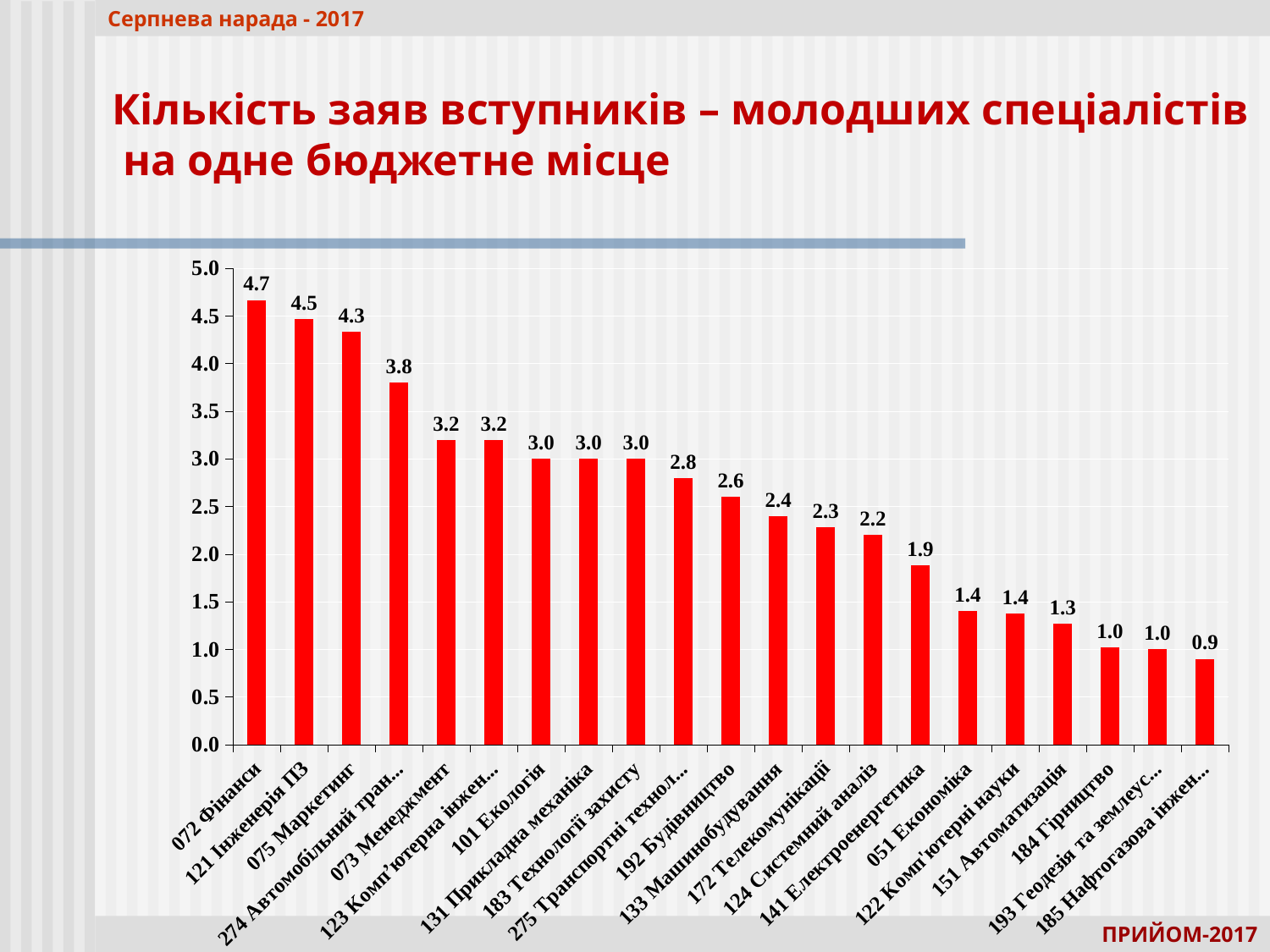
What is the value for 192 Будівництво? 2.6 Is the value for 133 Машинобудування greater or less than 2.0? greater Which category has the lowest value? 185 Нафтогазова інжен... Which category has the highest value? 072 Фінанси Do the values rise or fall from left to right along the x axis? fall How many categories are shown on the chart? 21 What is the value for 072 Фінанси? 4.7 What is the difference between the values for 075 Маркетинг and 073 Менеджмент? 1.1 What kind of chart is shown on the slide? bar chart Which is larger, the value for 121 Інженерія ПЗ or the value for 101 Екологія? 121 Інженерія ПЗ What is the value for 141 Електроенергетика? 1.9 What is the value for 151 Автоматизація? 1.3